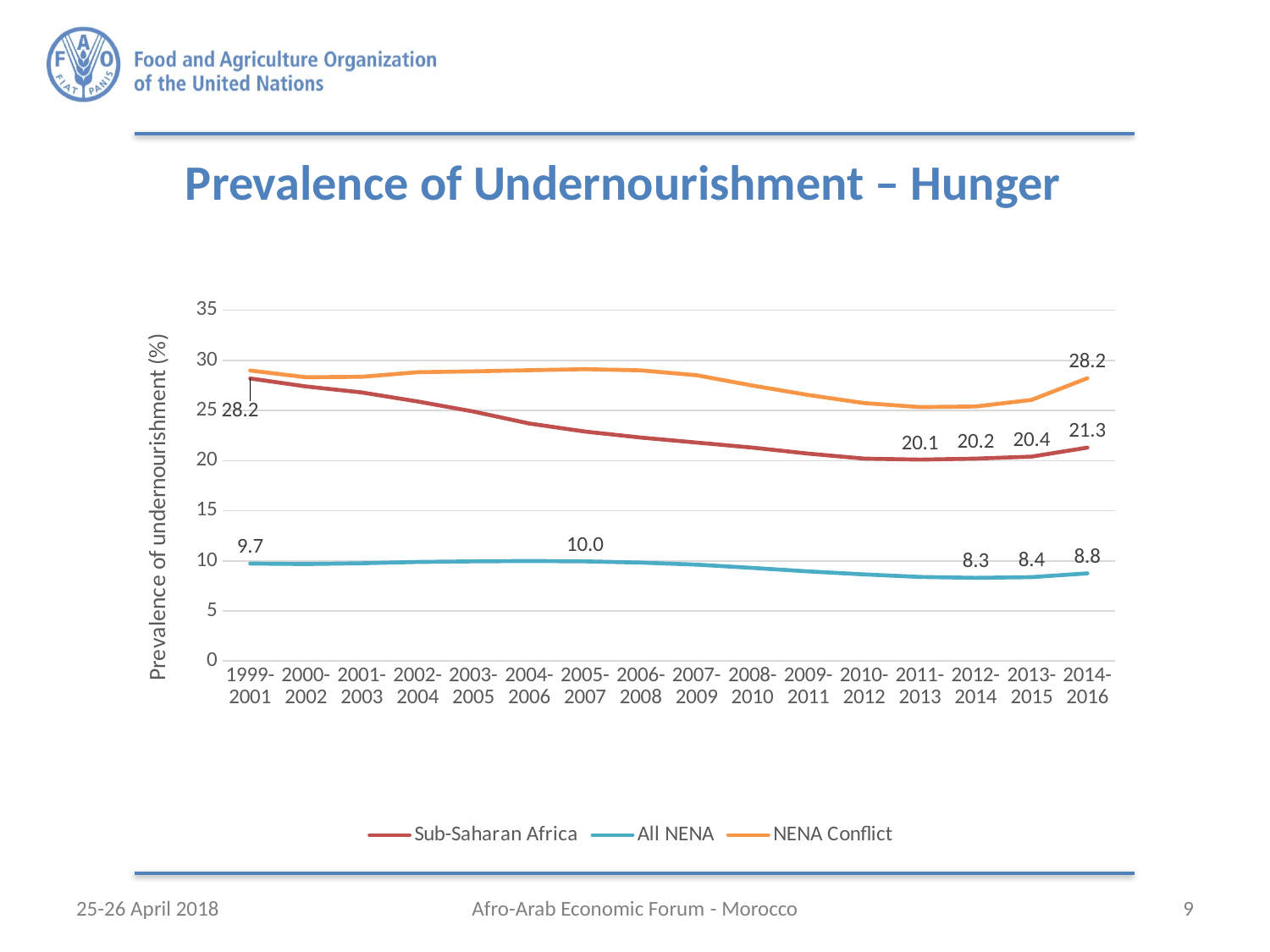
What is the value for All NENA in 2005-2007? 10.0 Does the Sub-Saharan Africa line rise or fall from 1999-2001 to 2011-2013? fall How many series does the legend list? 3 What is the difference between the All NENA values for 2014-2016 and 2012-2014? 0.5 What is the value for Sub-Saharan Africa in 2014-2016? 21.3 By how much did the Sub-Saharan Africa value fall from 1999-2001 to 2014-2016? 6.9 What is the value for All NENA in 2012-2014? 8.3 Is the value for NENA Conflict in 2005-2007 greater or less than 25? greater What kind of chart is shown on the slide? line chart What is the value for NENA Conflict in 2014-2016? 28.2 In 2014-2016, which is larger: NENA Conflict or Sub-Saharan Africa? NENA Conflict How many time periods are shown on the x axis? 16